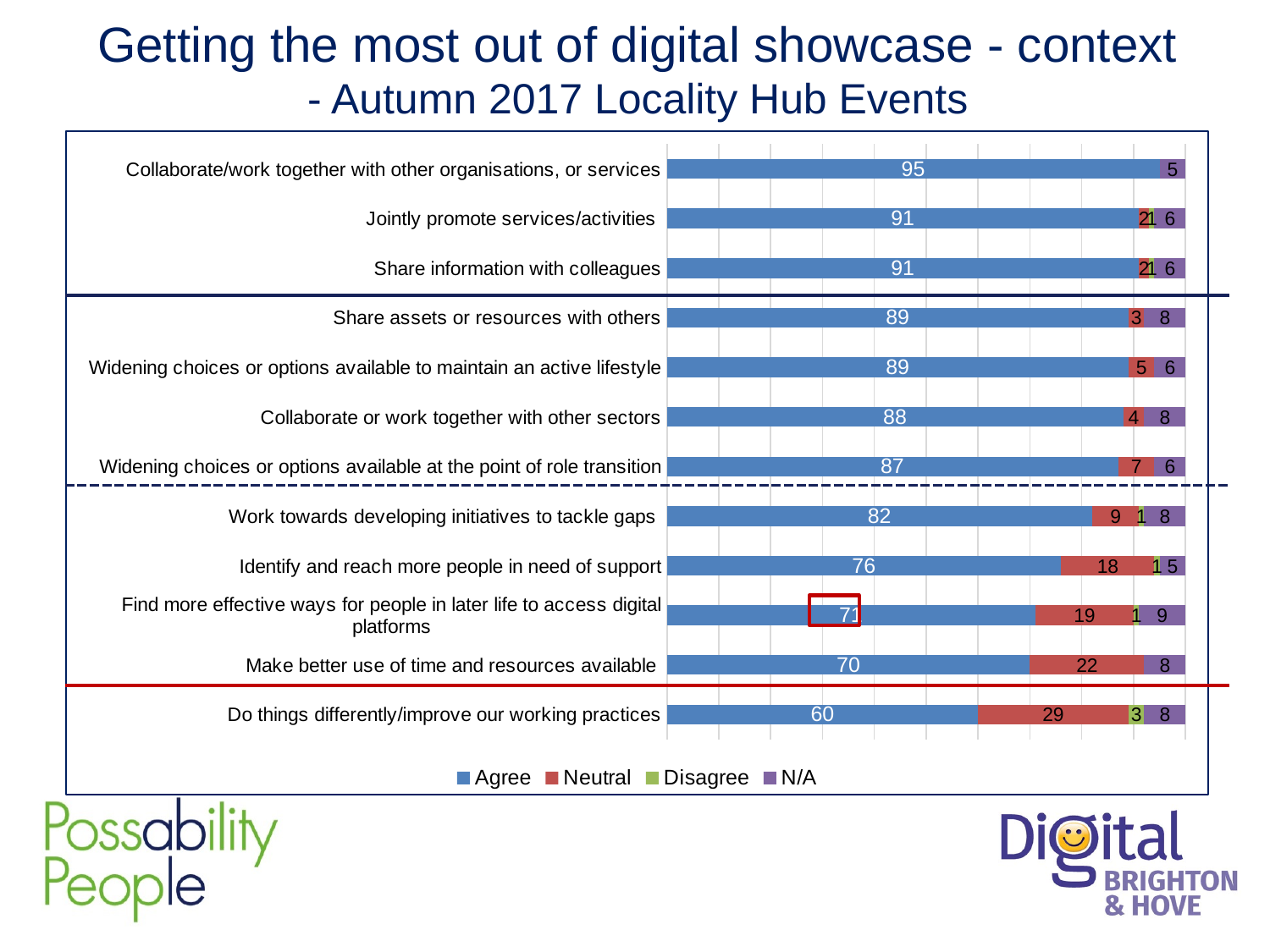
What is the Agree value for "Do things differently/improve our working practices"? 60 How many categories are shown in the chart? 12 Which category has the highest Agree value? Collaborate/work together with other organisations, or services Which category has the lowest Agree value? Do things differently/improve our working practices What kind of chart is shown on the slide? Stacked bar chart What is the Neutral value for "Make better use of time and resources available"? 22 What is the Agree value for "Collaborate/work together with other organisations, or services"? 95 How many series does the legend list? 4 What is the Agree value for "Find more effective ways for people in later life to access digital platforms"? 71 Which has a larger Agree value: "Identify and reach more people in need of support" or "Work towards developing initiatives to tackle gaps"? Work towards developing initiatives to tackle gaps What is the Neutral value for "Do things differently/improve our working practices"? 29 What is the difference between the highest Agree value (95) and the lowest Agree value (60)? 35